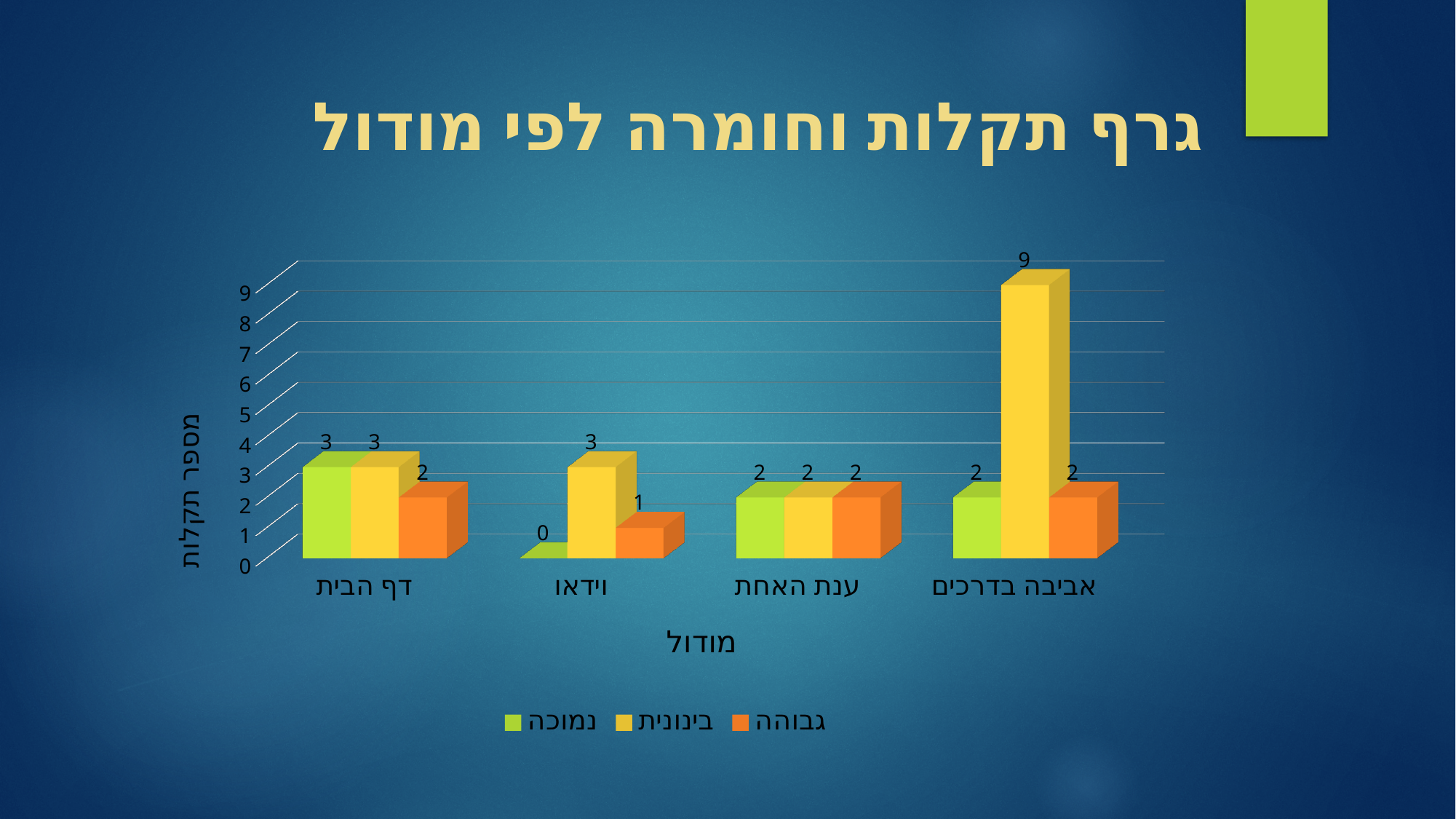
What is the value of the נמוכה series for וידאו? 0 Which category has the highest בינונית value? אביבה בדרכים What is the value of the גבוהה series for דף הבית? 2 Which category has the lowest נמוכה value? וידאו What kind of chart is shown on the slide? bar chart How many categories are shown on the x axis? 4 What is the difference between the בינונית value for אביבה בדרכים and the בינונית value for וידאו? 6 Which is larger: the גבוהה value for דף הבית or the גבוהה value for וידאו? דף הבית What is the title of the chart on the slide? גרף תקלות וחומרה לפי מודול What is the value of the בינונית series for אביבה בדרכים? 9 How many series does the legend list? 3 What is the label of the vertical axis? מספר תקלות